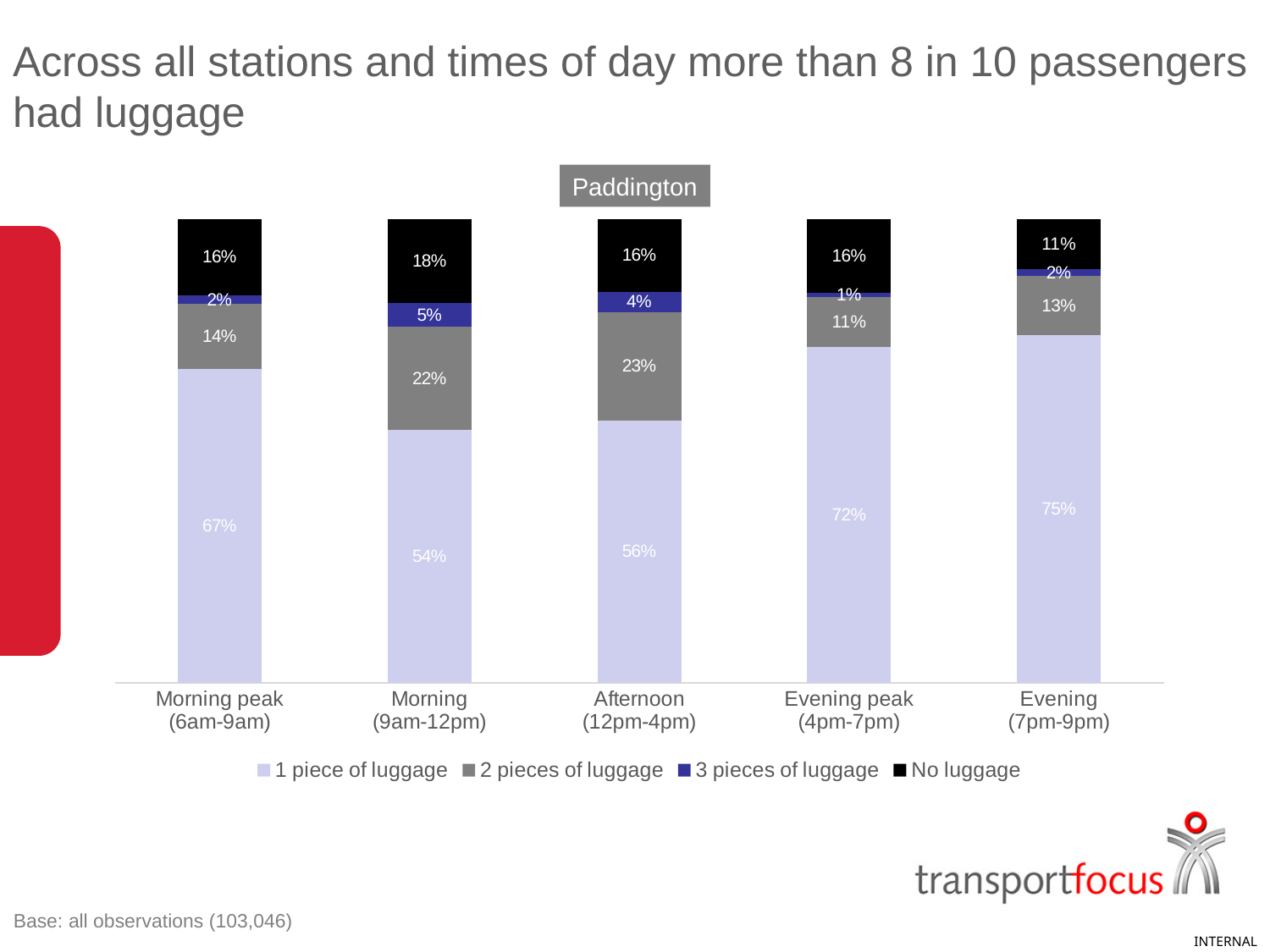
What percentage of passengers had 2 pieces of luggage in the Afternoon (12pm-4pm)? 23% Which time of day has the highest share of passengers with 1 piece of luggage? Evening (7pm-9pm) Which is larger: the 2 pieces of luggage share in the Morning (9am-12pm) or in the Evening peak (4pm-7pm)? Morning (9am-12pm) How many time-of-day categories are shown on the x axis? 5 What percentage of passengers had No luggage in the Morning (9am-12pm)? 18% What is the chart's title? Paddington Which time of day has the lowest share of passengers with 1 piece of luggage? Morning (9am-12pm) How many series does the legend list? 4 What percentage of passengers had 1 piece of luggage in the Morning peak (6am-9am)? 67% What percentage of passengers had 3 pieces of luggage in the Evening peak (4pm-7pm)? 1% What is the difference between the 1 piece of luggage share in the Evening (7pm-9pm) and in the Morning (9am-12pm)? 21 percentage points What kind of chart is shown on the slide? Stacked bar chart